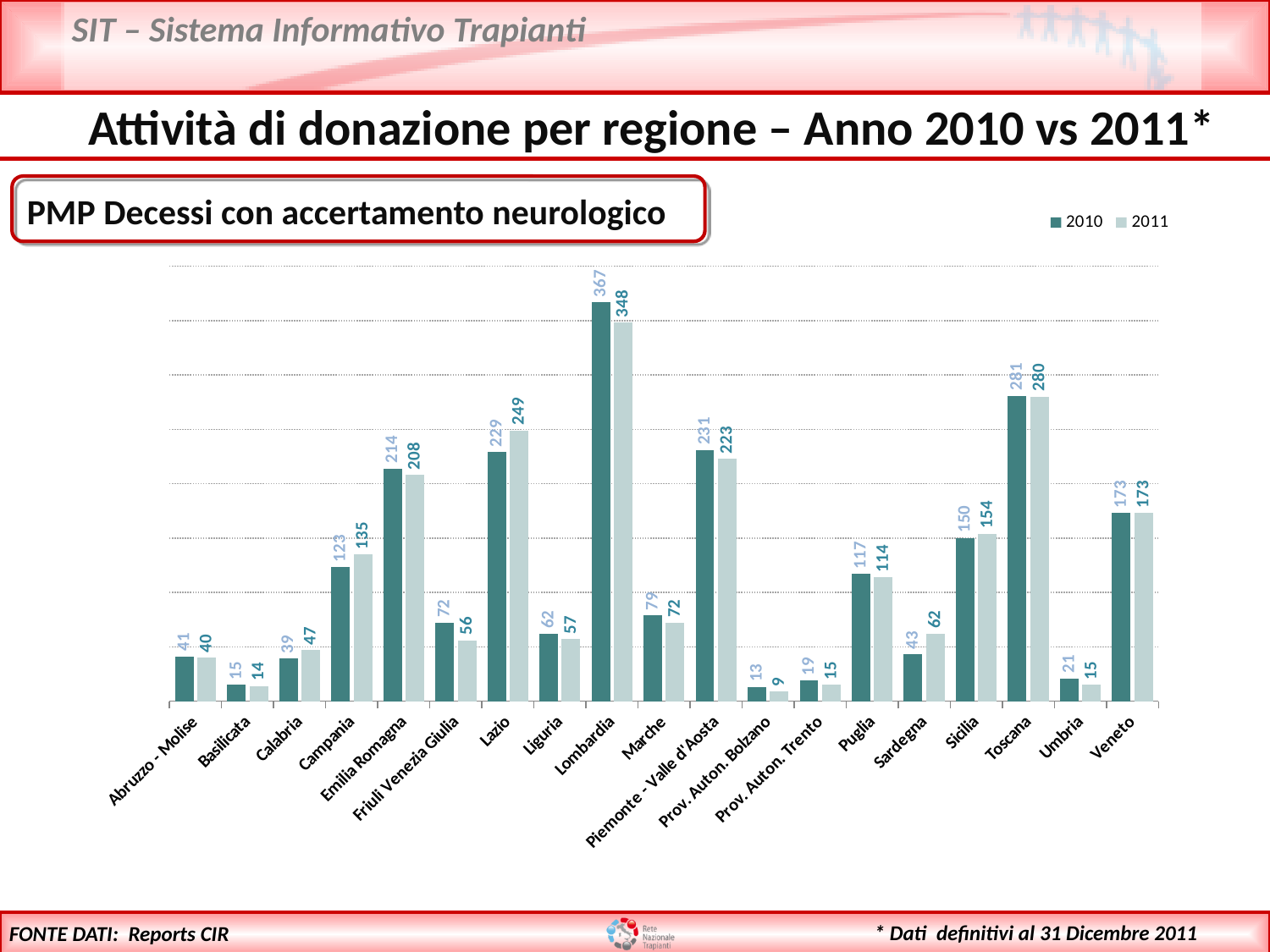
What are the two series named in the legend? 2010 and 2011 How many regions are shown on the x axis? 19 What is the difference between the 2010 values for Toscana and Piemonte - Valle d'Aosta? 50 What is the 2011 value for Lazio? 249 What is the 2011 value for Sardegna? 62 Which is larger for Campania: the 2010 value or the 2011 value? 2011 Which region has the highest 2011 value? Lombardia What kind of chart is shown on the slide? Bar chart What is the difference between the 2010 and 2011 values for Friuli Venezia Giulia? 16 How many series does the legend list? 2 What is the 2010 value for Lombardia? 367 Which region has the lowest 2010 value? Prov. Auton. Bolzano